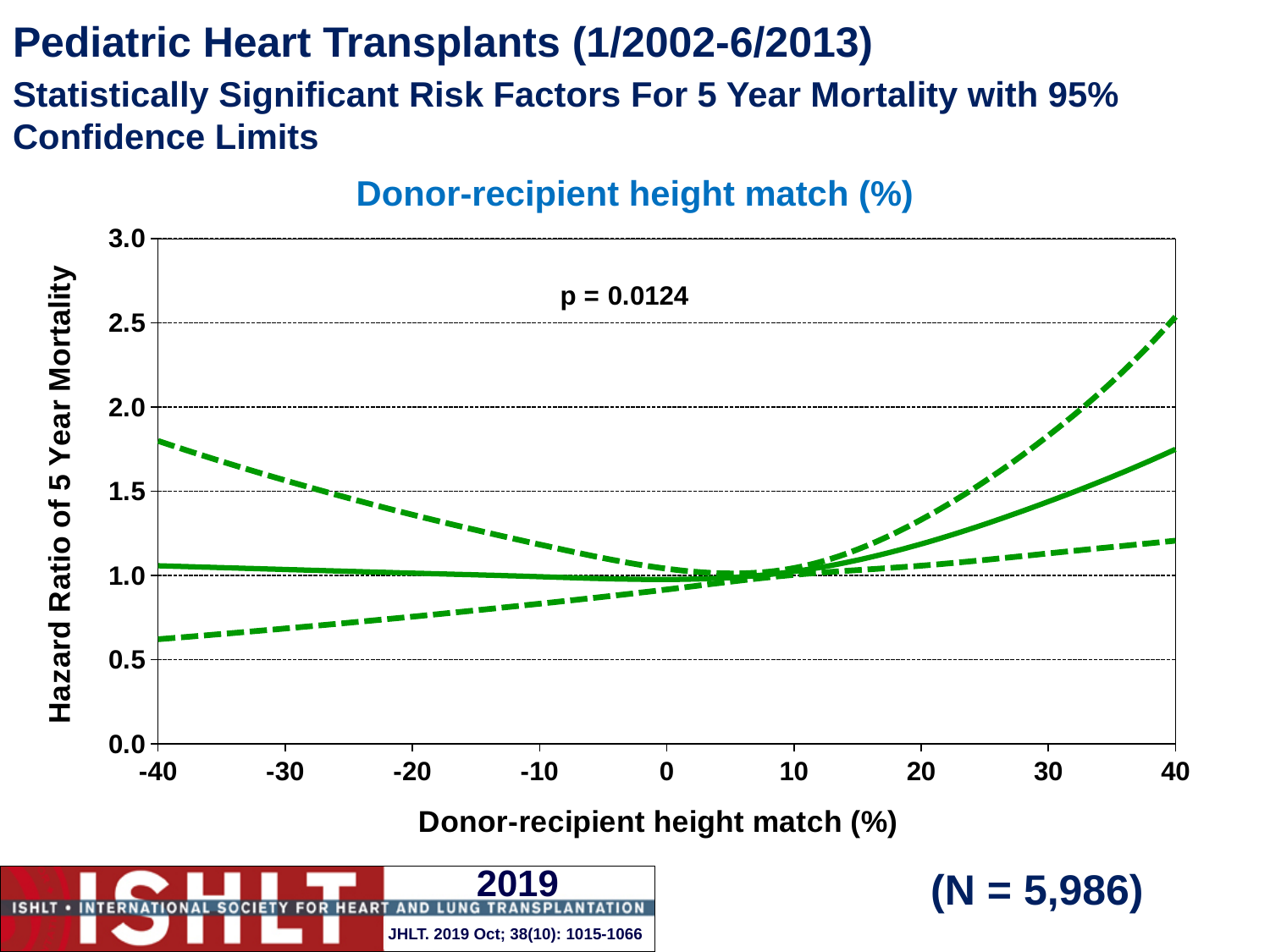
Does the upper dashed confidence limit rise or fall as donor-recipient height match goes from -40 to 0? fall What is the p-value printed on the chart? p = 0.0124 What is the title of the chart? Donor-recipient height match (%) Does the lower dashed confidence limit rise or fall as donor-recipient height match goes from -40 to 40? rise Does the solid hazard ratio line rise or fall as donor-recipient height match goes from 0 to 40? rise How many lines are plotted on the chart? 3 Is the value of the upper dashed confidence limit at a height match of 40 greater or less than 2.0? greater What kind of chart is shown on the slide? line chart Is the value of the upper dashed confidence limit at a height match of -40 greater or less than 1.5? greater Is the value of the solid hazard ratio line at a height match of 40 greater or less than 1.5? greater